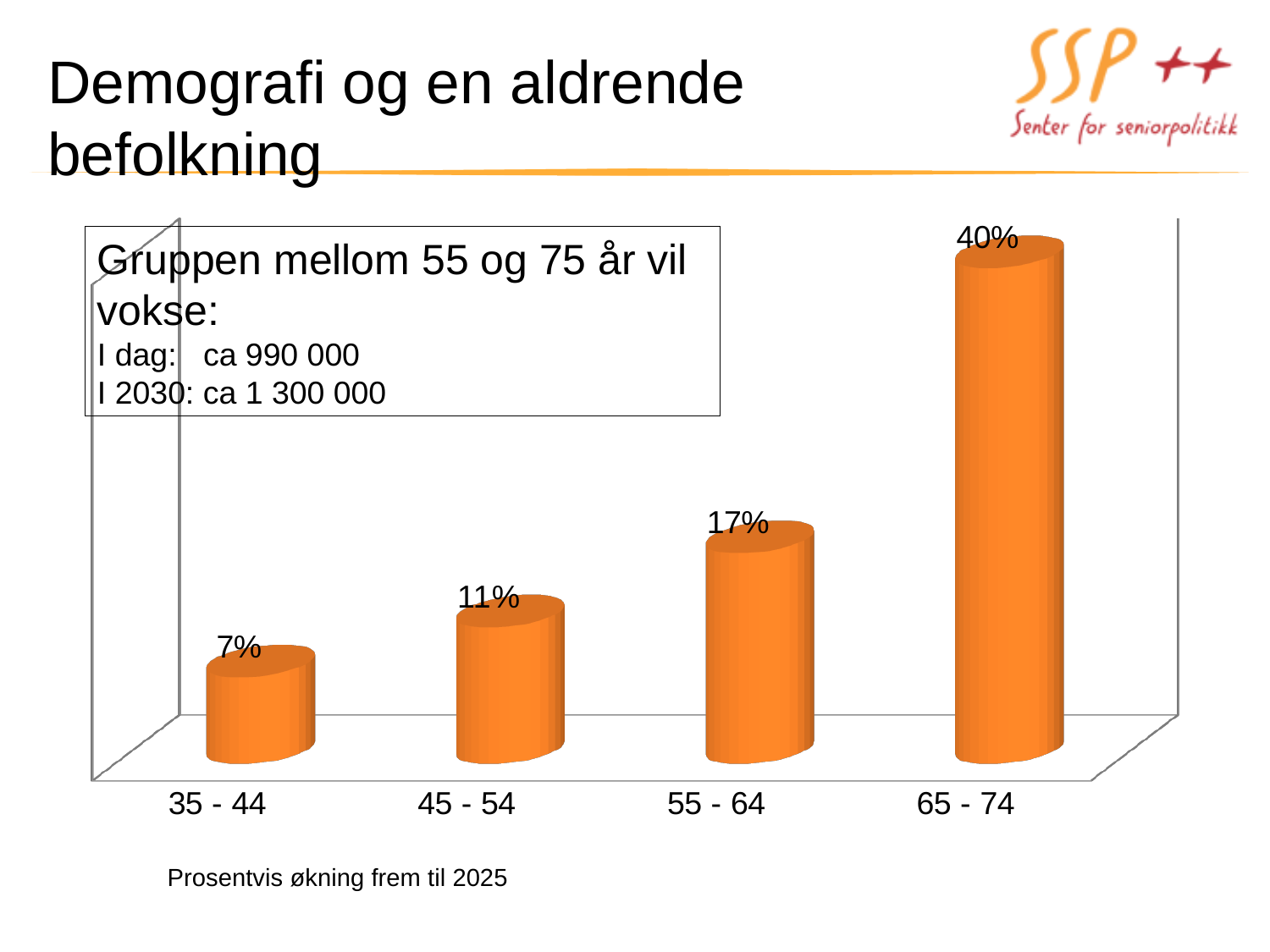
What is the difference between the values for 45 - 54 and 35 - 44? 4% What is the value for the 45 - 54 age group? 11% Which age group has the highest value? 65 - 74 Which is larger, the value for 55 - 64 or the value for 45 - 54? 55 - 64 Do the values rise or fall from the 35 - 44 group to the 65 - 74 group? Rise What is the difference between the values for 65 - 74 and 55 - 64? 23% What is the value for the 55 - 64 age group? 17% What is the value for the 35 - 44 age group? 7% What kind of chart is shown on the slide? Bar chart How many age groups are shown in the chart? 4 What is the value for the 65 - 74 age group? 40% Which age group has the lowest value? 35 - 44